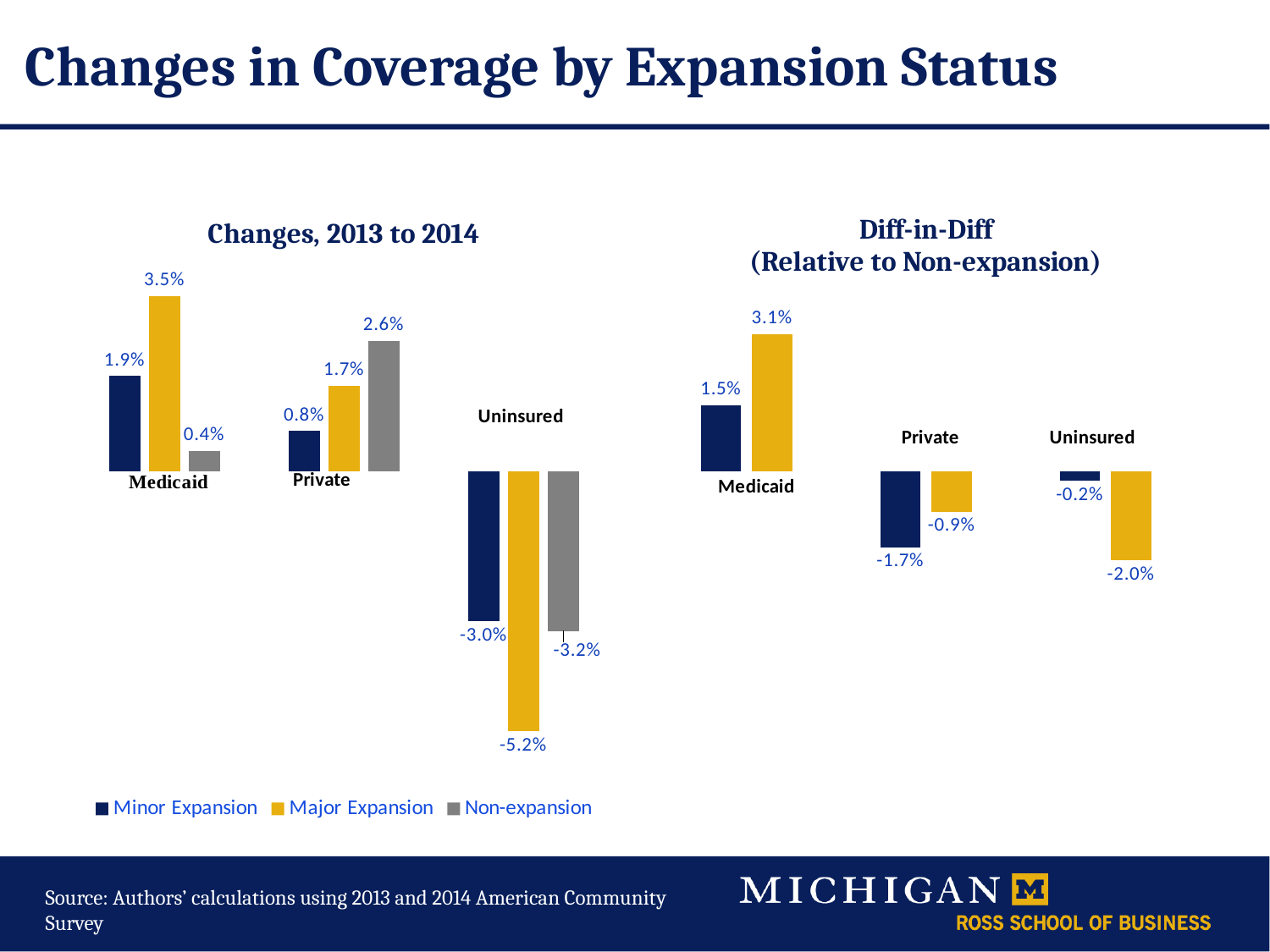
How many categories are shown on the x axis of the 'Changes, 2013 to 2014' chart? 3 How many series does the legend at the bottom of the slide list? 3 In the 'Diff-in-Diff (Relative to Non-expansion)' chart, what is the value for Minor Expansion in the Private category? -1.7% In the 'Changes, 2013 to 2014' chart, which series has the highest value in the Private category? Non-expansion In the 'Changes, 2013 to 2014' chart, what is the value for Non-expansion in the Uninsured category? -3.2% In the 'Changes, 2013 to 2014' chart, what is the difference between the Major Expansion and Minor Expansion values for Medicaid? 1.6% In the 'Diff-in-Diff (Relative to Non-expansion)' chart, which is larger for the Private category, Minor Expansion or Major Expansion? Major Expansion In the 'Changes, 2013 to 2014' chart, which series has the lowest value in the Uninsured category? Major Expansion In the 'Changes, 2013 to 2014' chart, what is the value for Major Expansion in the Medicaid category? 3.5% In the 'Diff-in-Diff (Relative to Non-expansion)' chart, what is the difference between the Major Expansion and Minor Expansion values for Medicaid? 1.6% What type of chart is the 'Diff-in-Diff (Relative to Non-expansion)' chart? Bar chart In the 'Diff-in-Diff (Relative to Non-expansion)' chart, what is the value for Major Expansion in the Uninsured category? -2.0%